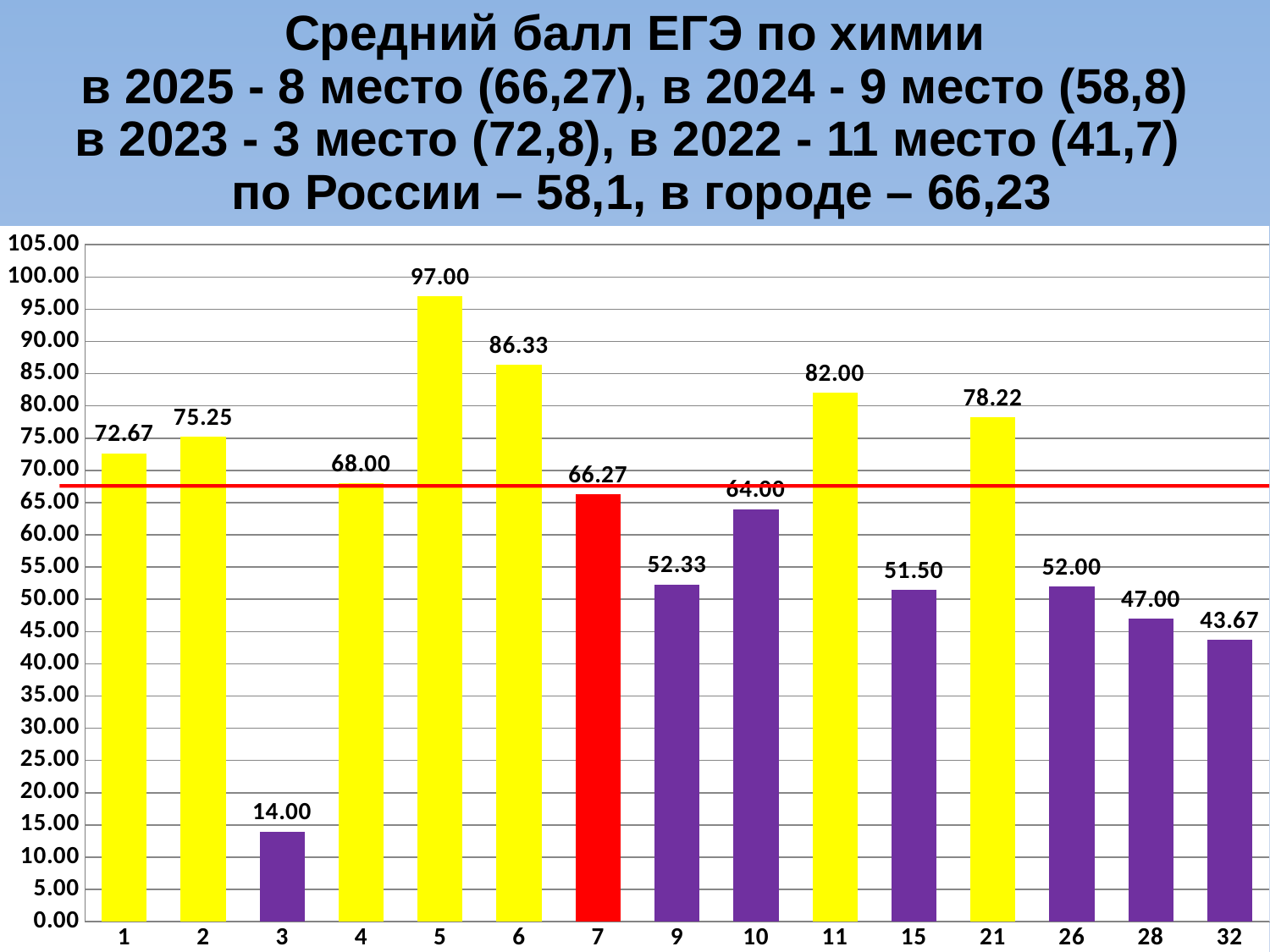
What is the value for category 7? 66.27 How many bars are shown in the chart? 15 Is the value for category 10 greater or less than 60.00? greater What is the value for category 5? 97.00 Which is larger, the value for category 1 or the value for category 2? 2 What colour is the bar for category 7? red What is the difference between the values for category 11 and category 21? 3.78 Which category has the highest value? 5 What is the value for category 32? 43.67 What is the difference between the values for category 5 and category 6? 10.67 What kind of chart is shown on the slide? bar chart Which category has the lowest value? 3